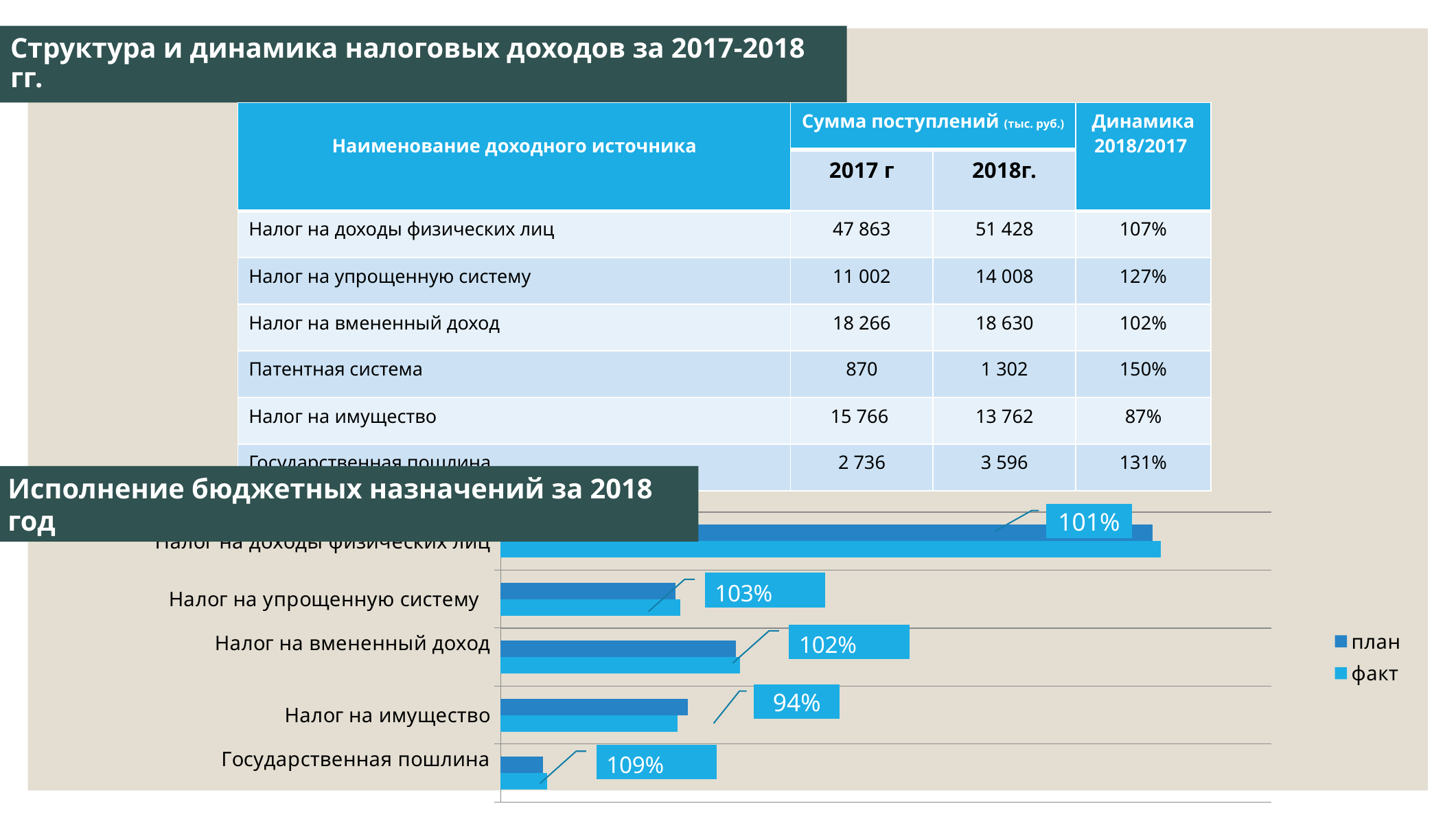
What percentage label is shown for 'Налог на упрощенную систему' in the bar chart? 103% Which category in the bar chart has the highest percentage label? Государственная пошлина What kind of chart is shown at the bottom of the slide under 'Исполнение бюджетных назначений за 2018 год'? Bar chart In the bar chart, which category has the longest bars? Налог на доходы физических лиц In the bar chart, what is the difference between the percentage labels for 'Государственная пошлина' and 'Налог на имущество'? 15% Which category in the bar chart has the lowest percentage label? Налог на имущество How many series does the legend of the bar chart list? 2 How many categories are shown in the bar chart? 5 What percentage label is shown for 'Налог на имущество' in the bar chart? 94% What percentage label is shown for 'Налог на доходы физических лиц' in the bar chart? 101% What are the two series named in the legend of the bar chart? план and факт What percentage label is shown for 'Государственная пошлина' in the bar chart? 109%